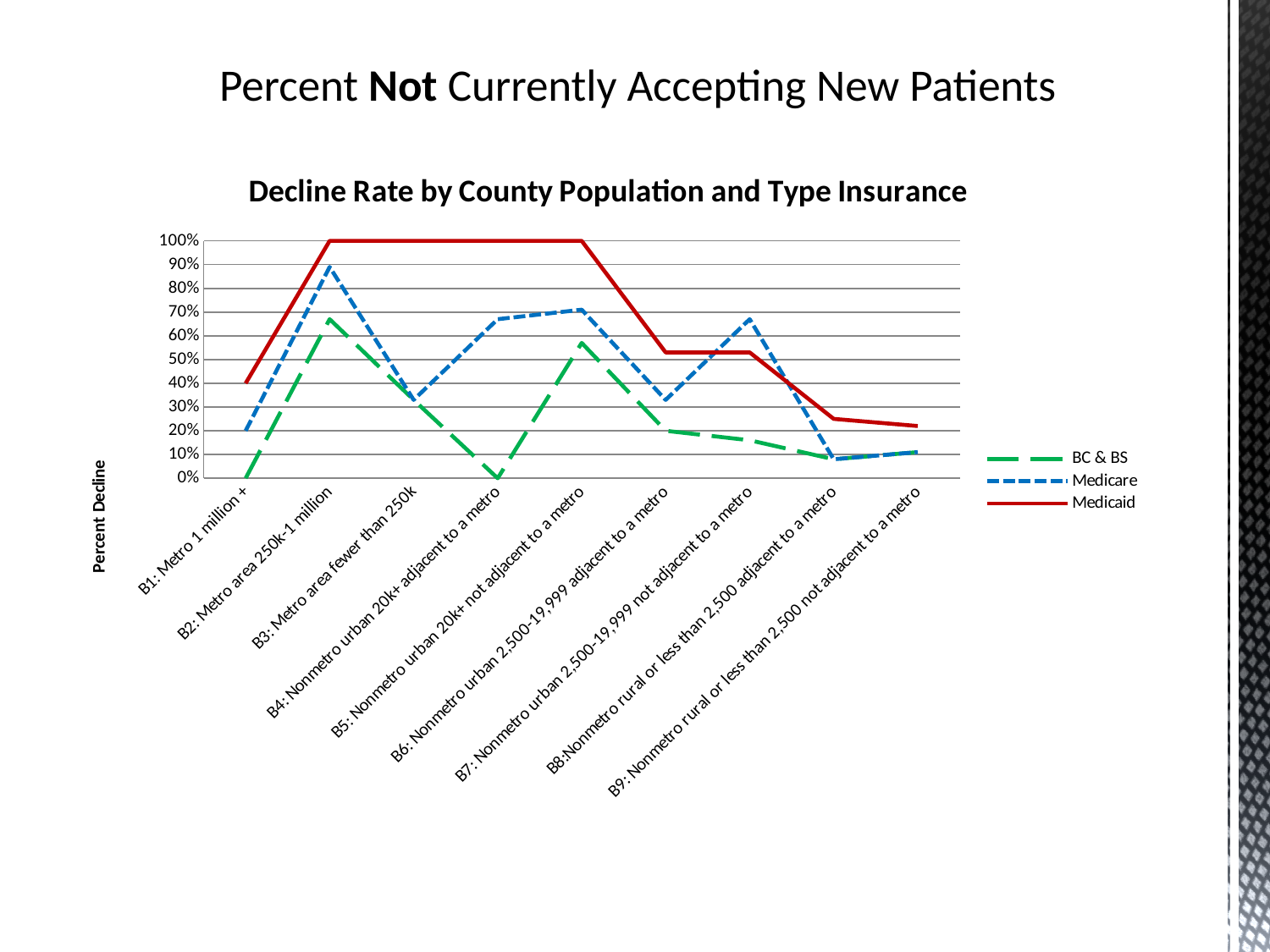
What is the BC & BS value for B1: Metro 1 million +? 0% What is the Medicaid value for B1: Metro 1 million +? 40% Is the BC & BS value for B8: Nonmetro rural or less than 2,500 adjacent to a metro greater or less than 20%? less What is the BC & BS value for B4: Nonmetro urban 20k+ adjacent to a metro? 0% How many county population categories are plotted along the x axis? 9 Which series has the highest value for B1: Metro 1 million +? Medicaid Does the Medicaid line rise or fall from B5 to B9? fall What is the Medicaid value for B2: Metro area 250k-1 million? 100% For B7: Nonmetro urban 2,500-19,999 not adjacent to a metro, which is larger, the Medicare value or the BC & BS value? Medicare What kind of chart is shown on the slide? line chart Is the Medicare value for B5: Nonmetro urban 20k+ not adjacent to a metro greater or less than 60%? greater How many series does the legend list? 3